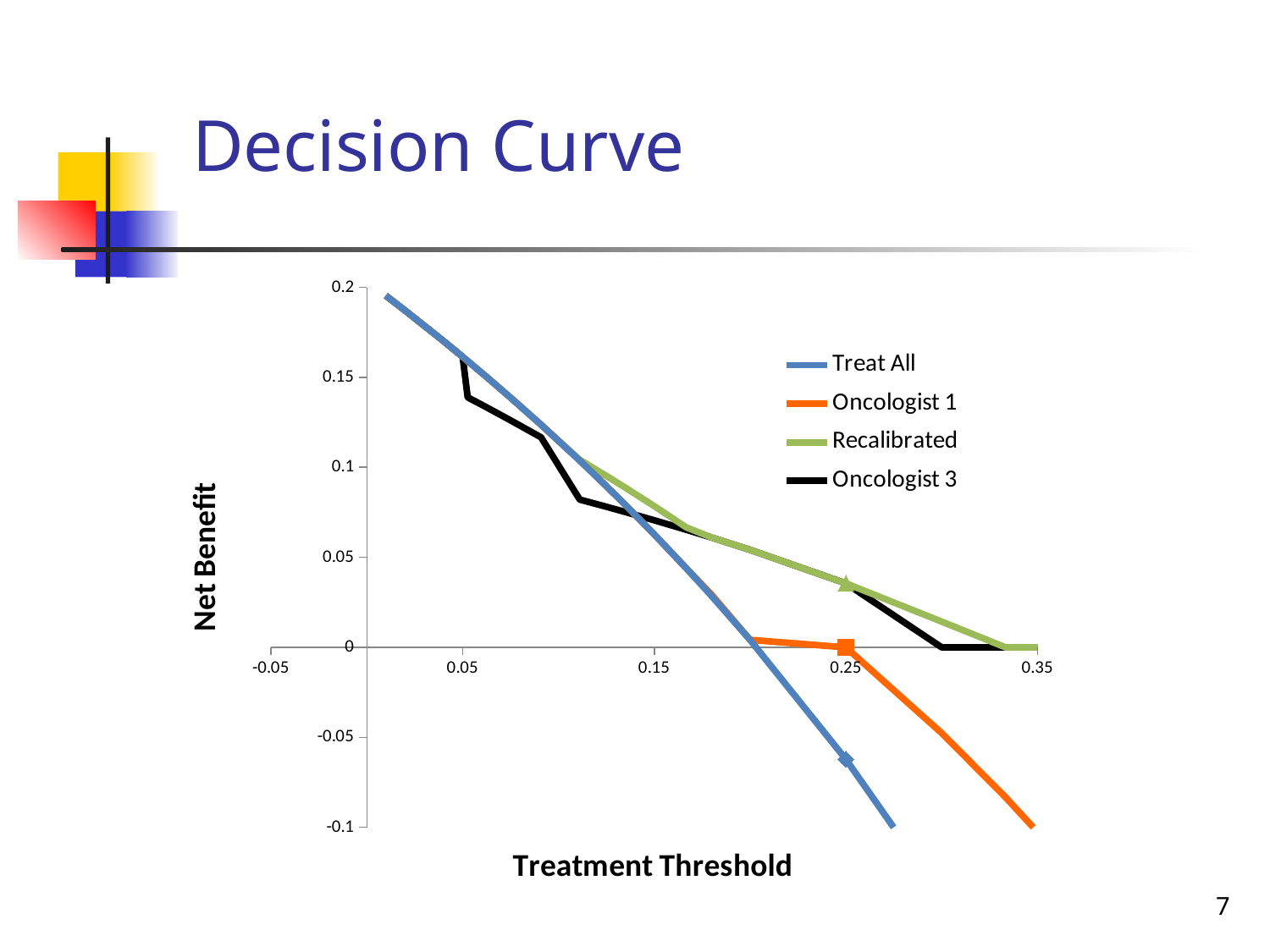
Does the Oncologist 1 line rise or fall as the treatment threshold increases? fall Is the net benefit for Recalibrated at a treatment threshold of 0.15 greater or less than 0.05? greater How many series does the legend list? 4 What is the title of the chart? Decision Curve At a treatment threshold of 0.3, which series has the higher net benefit, Recalibrated or Treat All? Recalibrated What kind of chart is shown on the slide? line chart Does the Treat All line rise or fall as the treatment threshold increases? fall At a treatment threshold of 0.35, which series has the higher net benefit, Recalibrated or Oncologist 1? Recalibrated Is the net benefit for Treat All at a treatment threshold of 0.3 greater or less than 0? less Is the net benefit for Recalibrated at a treatment threshold of 0.25 greater or less than 0? greater What is the label of the x axis? Treatment Threshold